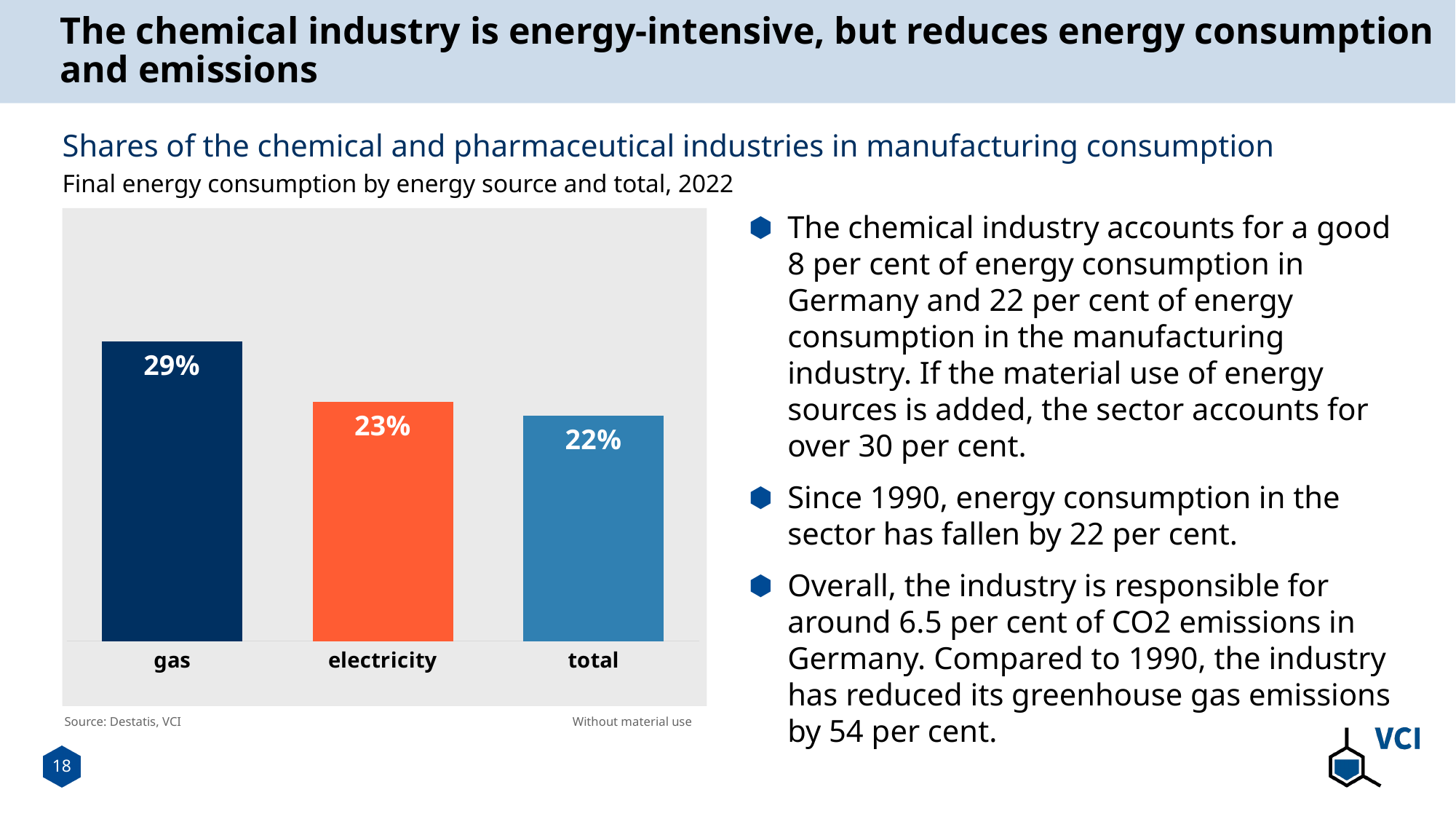
Which is larger, the share for gas or the share for electricity? gas What colour is the bar for electricity? orange Which category has the highest share? gas How many categories are shown in the chart? 3 What is the difference between the shares for gas and total? 7 percentage points What is the difference between the shares for gas and electricity? 6 percentage points Do the values rise or fall from left to right across the categories? fall What is the share shown for gas? 29% Which category has the lowest share? total What kind of chart is shown on the slide? bar chart What is the share shown for total? 22% What is the share shown for electricity? 23%